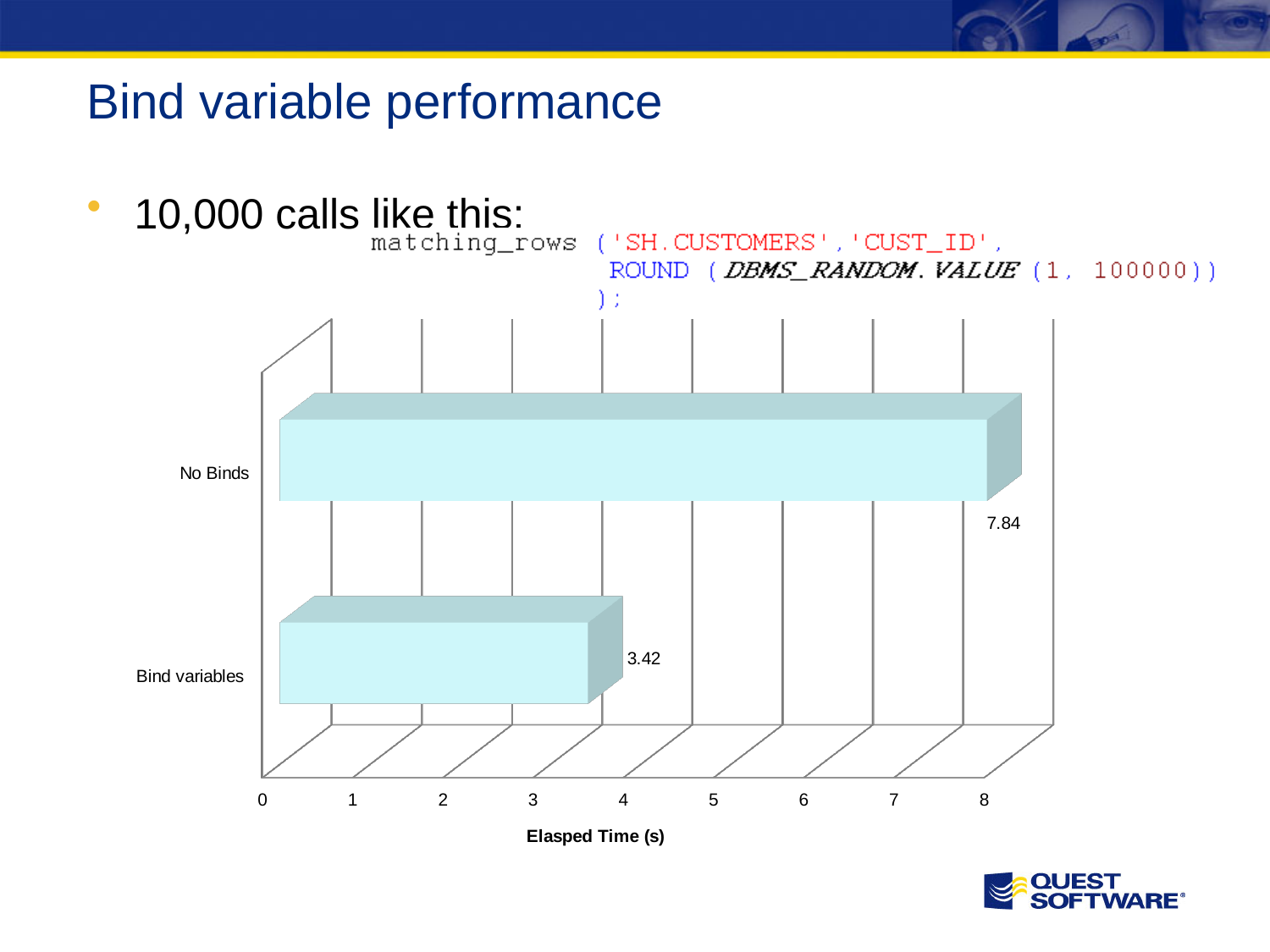
Which category has the lowest elapsed time? Bind variables What is the highest value shown on the horizontal axis? 8 Is the value for No Binds greater or less than 7? greater What is the label of the horizontal axis? Elasped Time (s) Which category has the highest elapsed time? No Binds What is the elapsed time for Bind variables? 3.42 What is the elapsed time for No Binds? 7.84 What kind of chart is shown on the slide? bar chart What is the difference in elapsed time between No Binds and Bind variables? 4.42 Is the value for Bind variables greater or less than 4? less How many categories are shown in the chart? 2 Which has a larger elapsed time, No Binds or Bind variables? No Binds